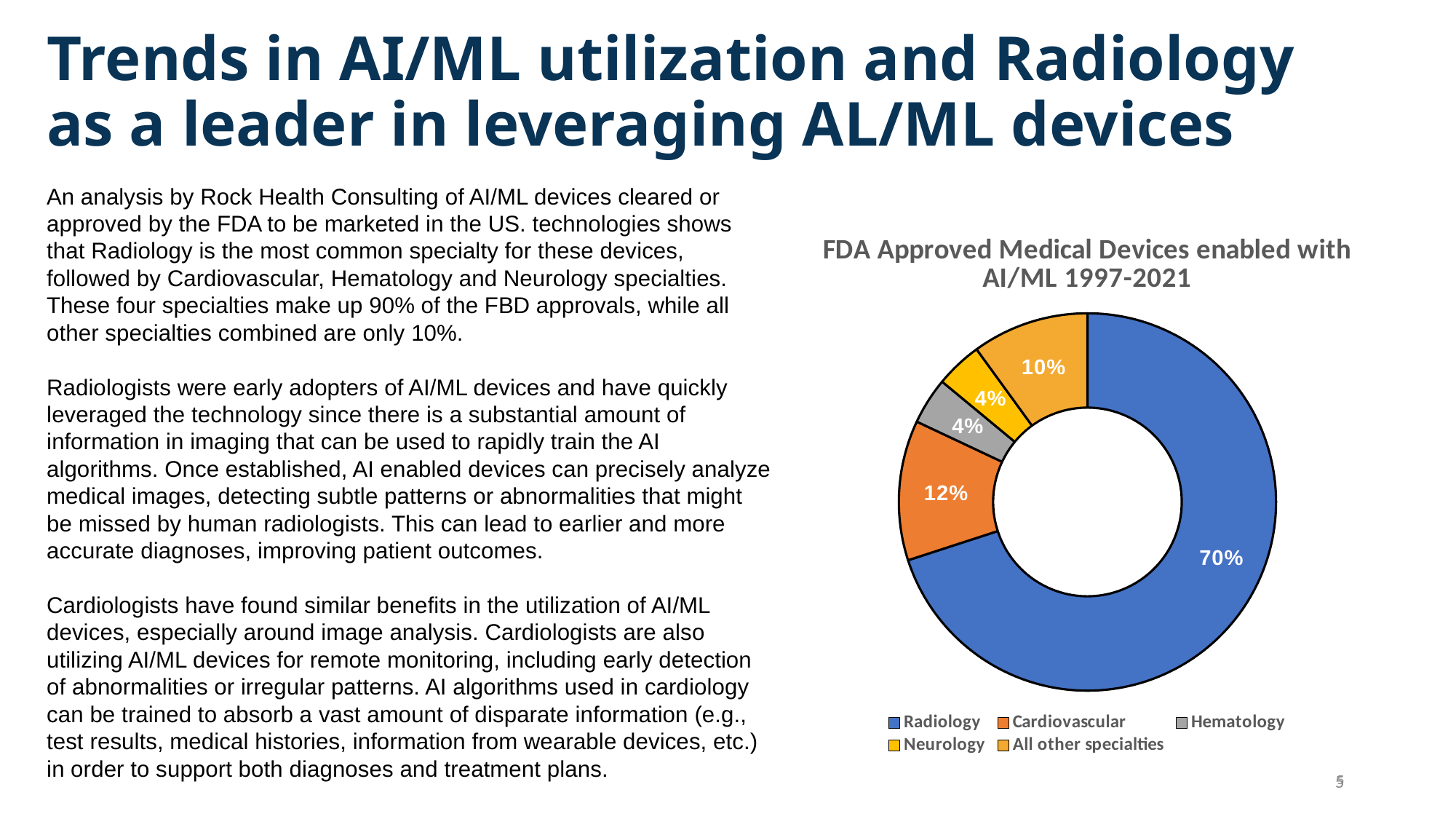
What is the difference in percentage points between Radiology and Cardiovascular? 58 Which specialty has the largest share in the chart? Radiology What kind of chart is shown on the slide? Doughnut chart What percentage is shown for All other specialties in the chart? 10% What is the title of the chart? FDA Approved Medical Devices enabled with AI/ML 1997-2021 What share of the doughnut chart does Radiology account for? 70% Which has a larger share, Cardiovascular or All other specialties? Cardiovascular How many categories does the chart show? 5 What percentage is shown for Hematology in the chart? 4% What colour represents Radiology in the chart? Blue What percentage is shown for Cardiovascular in the chart? 12% What is the combined share of Hematology and Neurology? 8%